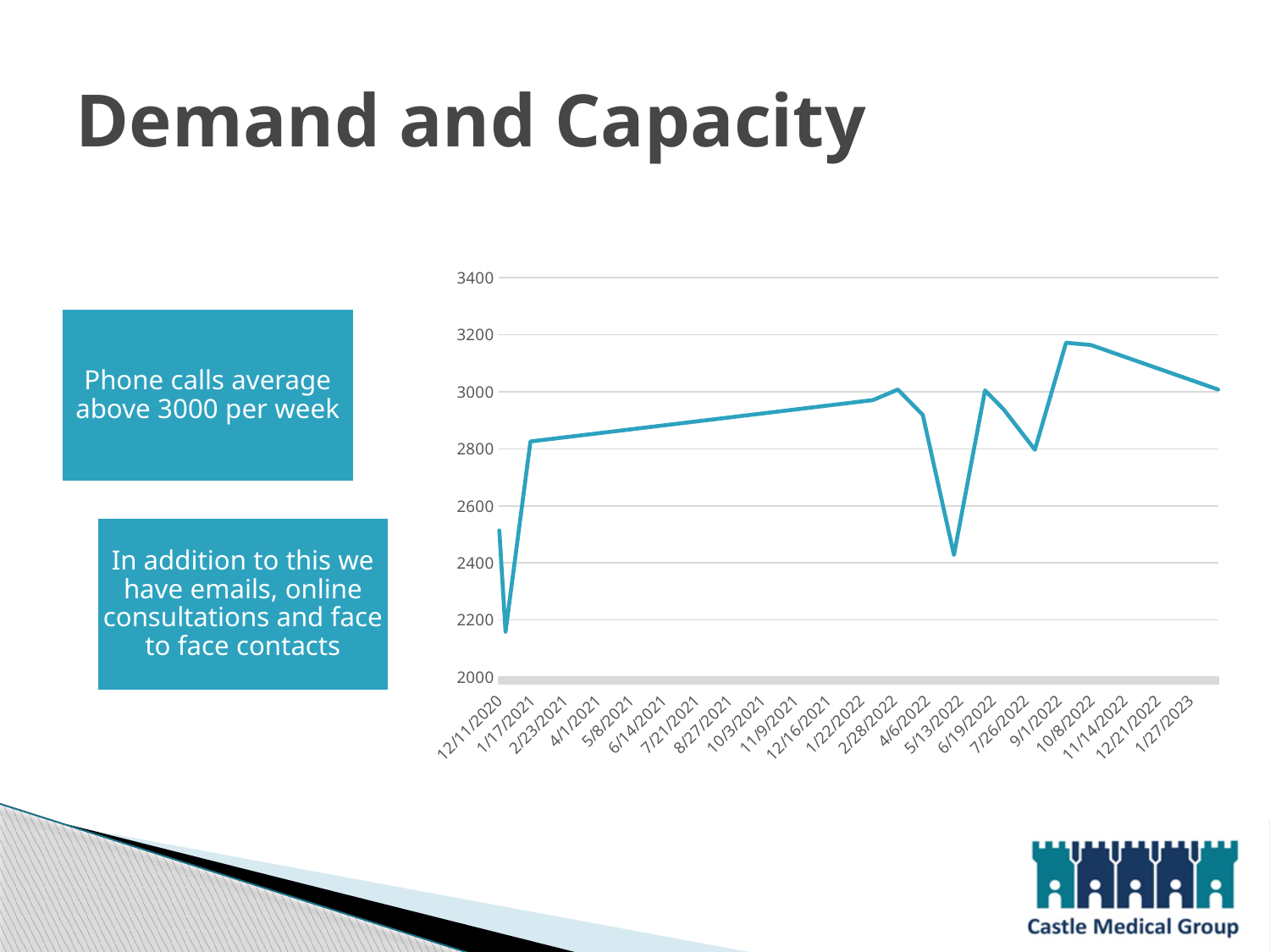
What is the first date label on the x axis of the chart? 12/11/2020 How many date labels are shown along the x axis of the chart? 22 How many lines (series) are plotted on the chart? 1 What kind of chart is shown on the slide? line chart What is the highest value shown on the y axis of the chart? 3400 Is the highest point on the line greater or less than 3000? greater Is the lowest point on the line greater or less than 2200? less Is the dip in the line around 5/13/2022 greater or less than 2600? less Which is larger: the value of the line near 10/8/2022 or the value near 1/17/2021? 10/8/2022 Overall, does the line rise or fall from the first date to the last date on the x axis? rise